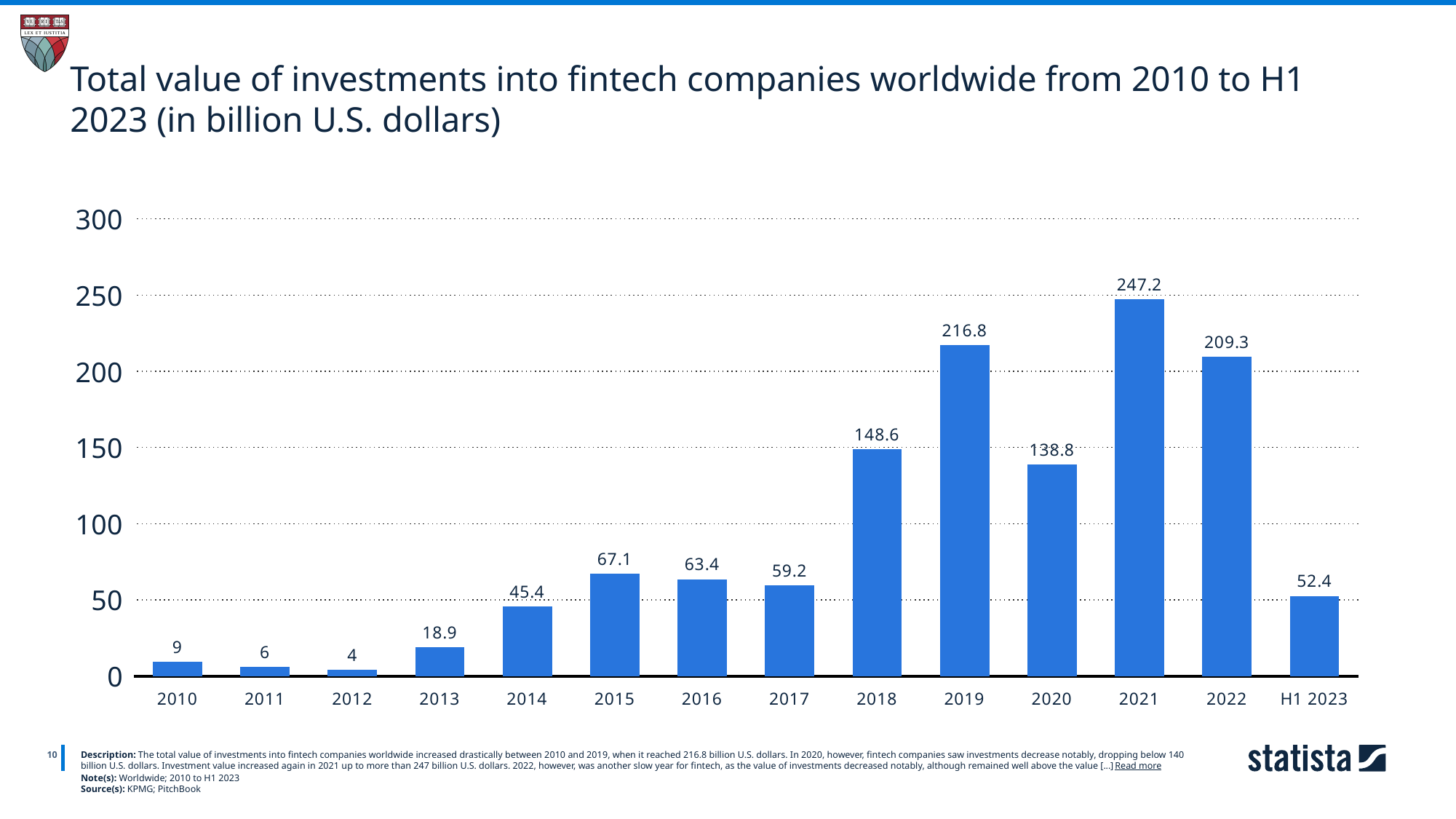
Which is larger, the value for 2019 or the value for 2020? 2019 What is the difference between the values for 2021 and 2022? 37.9 Which year has the lowest value? 2012 What kind of chart is this? bar chart Do the values rise or fall from 2012 to 2015? rise Is the value for 2020 greater or less than 100? greater How many categories are shown on the x axis? 14 What unit are the values given in, according to the chart title? billion U.S. dollars Which year has the highest value? 2021 What is the value for H1 2023? 52.4 What is the value for 2021? 247.2 What is the value for 2018? 148.6